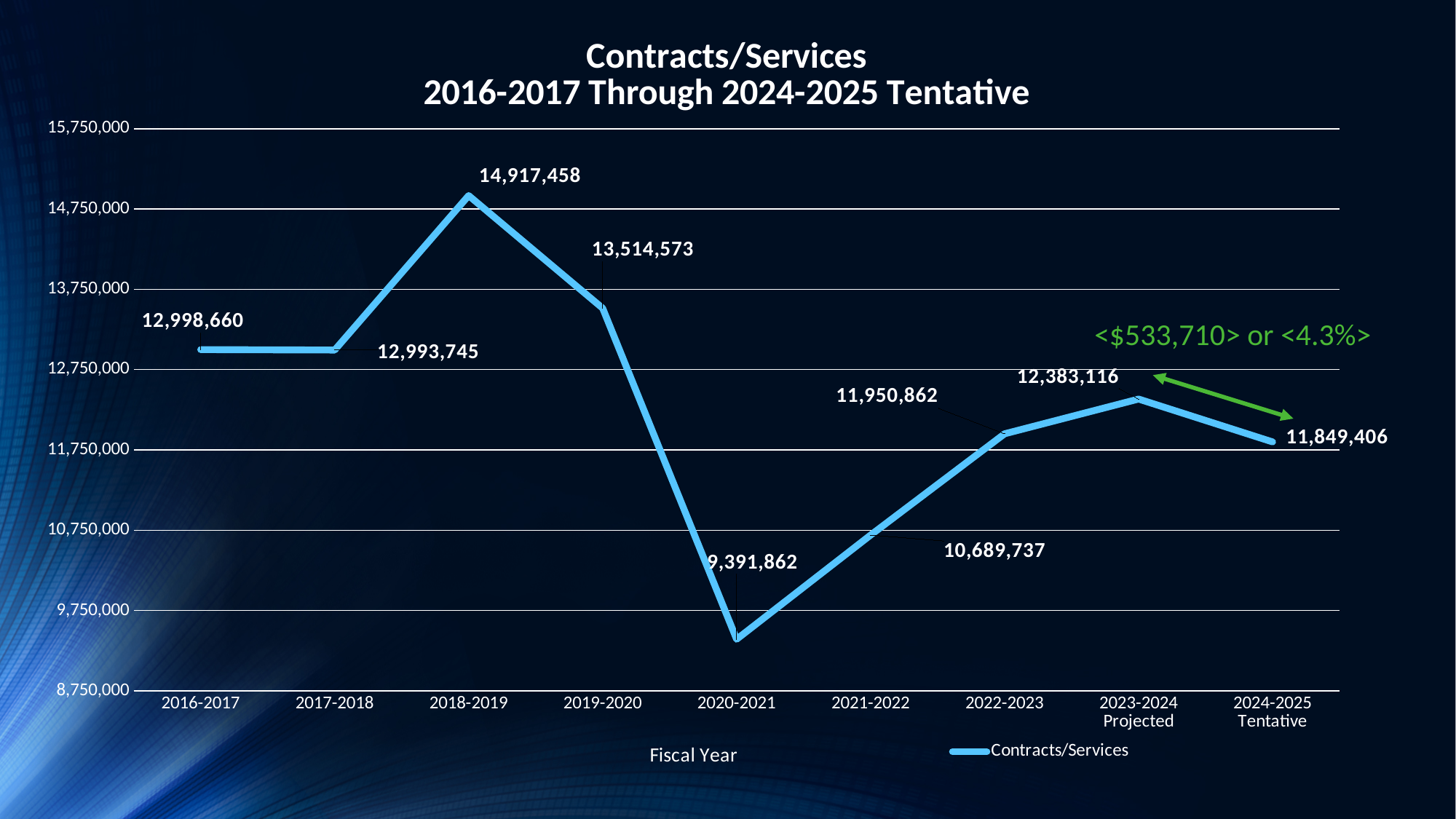
Which fiscal year has the lowest Contracts/Services value? 2020-2021 Is the value for 2020-2021 greater or less than 9,750,000? less Which is larger, the value for 2019-2020 or the value for 2022-2023? 2019-2020 What is the Contracts/Services value for 2020-2021? 9,391,862 Which fiscal year has the highest Contracts/Services value? 2018-2019 What is the Contracts/Services value for 2018-2019? 14,917,458 What is the difference between the highest value (2018-2019) and the lowest value (2020-2021)? 5,525,596 Do the values rise or fall from 2020-2021 to 2023-2024 Projected? rise What kind of chart is shown on the slide? line chart What is the difference between the 2023-2024 Projected value and the 2024-2025 Tentative value? 533,710 How many fiscal years are plotted on the chart? 9 What is the Contracts/Services value for 2024-2025 Tentative? 11,849,406